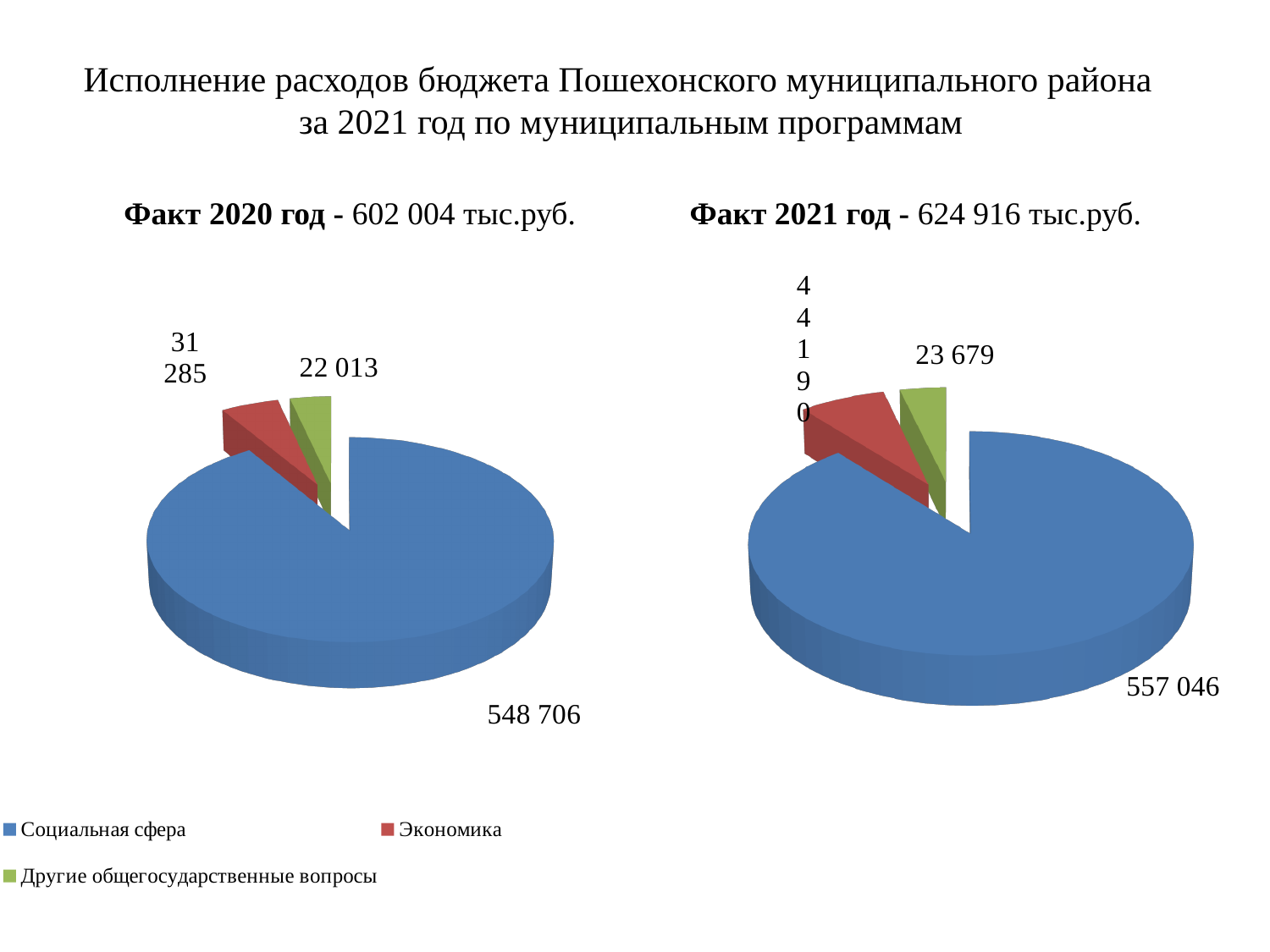
In the 'Факт 2020 год' chart, what is the difference between Экономика and Другие общегосударственные вопросы? 9 272 What total is stated in the heading of the 'Факт 2021 год' chart? 624 916 тыс.руб. In the 'Факт 2020 год' chart, what is the value for Экономика? 31 285 In the 'Факт 2021 год' chart, what is the value for Другие общегосударственные вопросы? 23 679 In the 'Факт 2021 год' chart, which category has the smallest slice? Другие общегосударственные вопросы How many slices does the 'Факт 2021 год' pie chart have? 3 In the 'Факт 2020 год' chart, which category has the largest slice? Социальная сфера Is the value for Социальная сфера larger in the 'Факт 2020 год' chart or in the 'Факт 2021 год' chart? Факт 2021 год In the 'Факт 2021 год' chart, what is the value for Социальная сфера? 557 046 In the 'Факт 2020 год' chart, what is the value for Социальная сфера? 548 706 What kind of charts are shown on the slide? Pie charts In the 'Факт 2020 год' chart, what is the value for Другие общегосударственные вопросы? 22 013